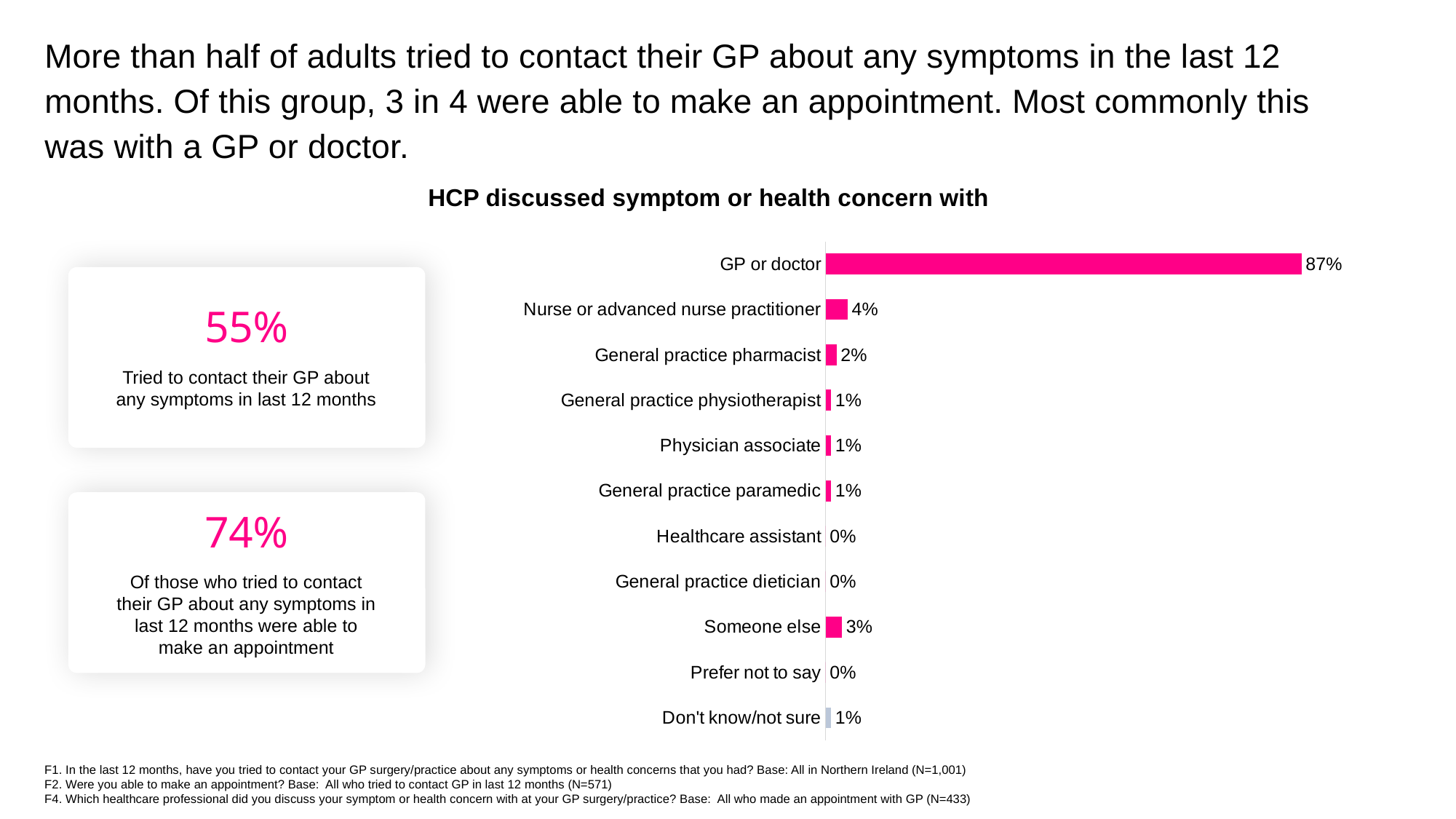
What is the value for General practice pharmacist? 2% What is the value for Healthcare assistant? 0% What percentage discussed their symptom or health concern with a GP or doctor? 87% What is the value for Someone else? 3% What is the difference between the values for GP or doctor and Nurse or advanced nurse practitioner? 83% What is the difference between the values for Someone else and General practice pharmacist? 1% What is the value for Nurse or advanced nurse practitioner? 4% Which is larger, the value for Nurse or advanced nurse practitioner or the value for Someone else? Nurse or advanced nurse practitioner Which category has the highest value? GP or doctor How many categories are shown in the chart? 11 What is the title of the chart? HCP discussed symptom or health concern with What kind of chart is shown on the slide? Bar chart